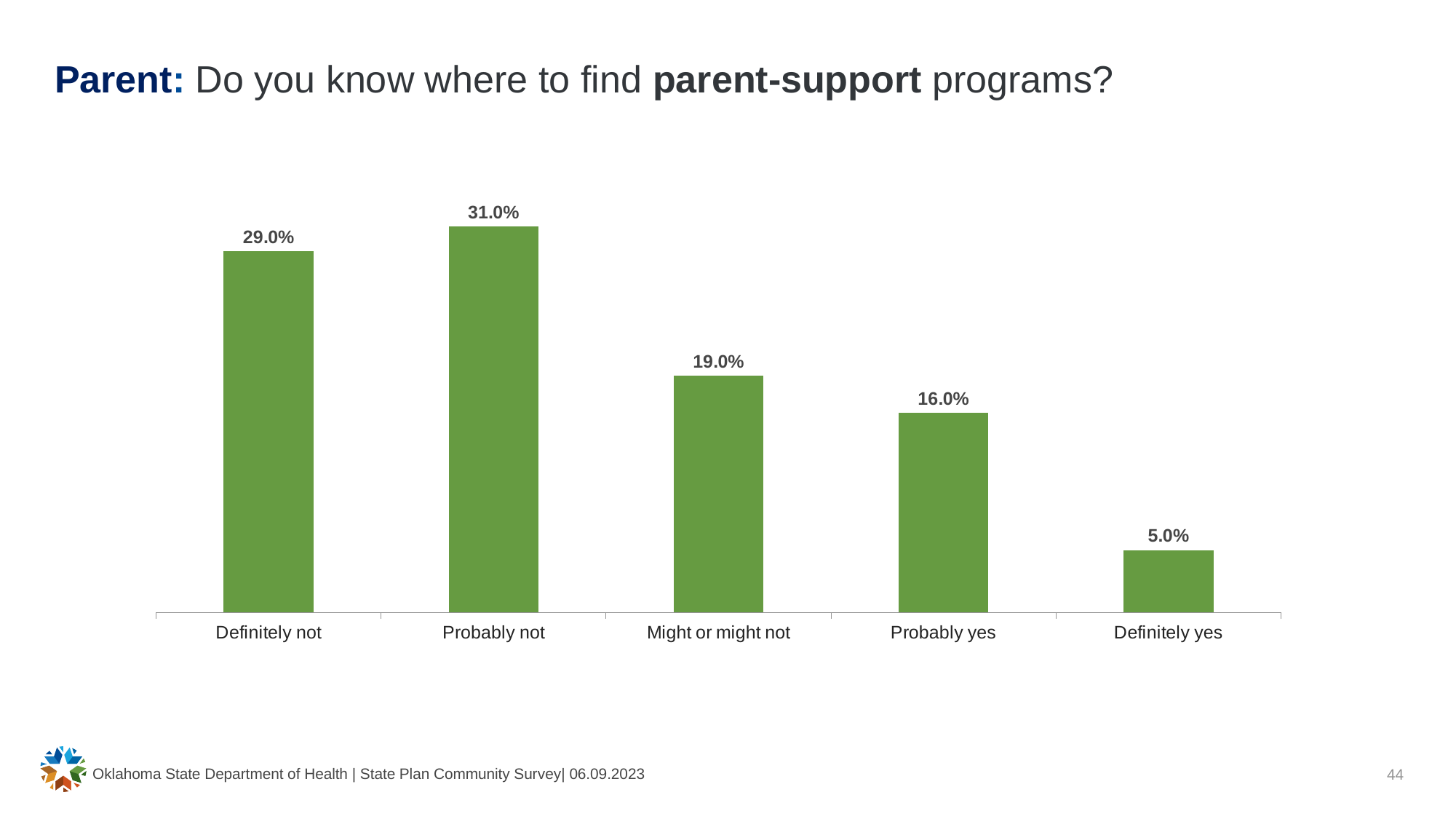
What percentage of parents answered "Probably yes"? 16.0% How many response categories are shown on the chart? 5 What is the value shown for "Might or might not"? 19.0% Do the values generally rise or fall from "Probably not" to "Definitely yes" along the x axis? Fall Which response category has the lowest percentage? Definitely yes What is the difference between the "Might or might not" and "Definitely yes" percentages? 14.0% What type of chart is shown on the slide? Bar chart Which is larger, the value for "Probably yes" or the value for "Might or might not"? Might or might not What percentage of parents answered "Definitely not"? 29.0% What is the difference between the "Probably not" and "Definitely not" percentages? 2.0% Which response category has the highest percentage? Probably not What colour are the bars in the chart? Green